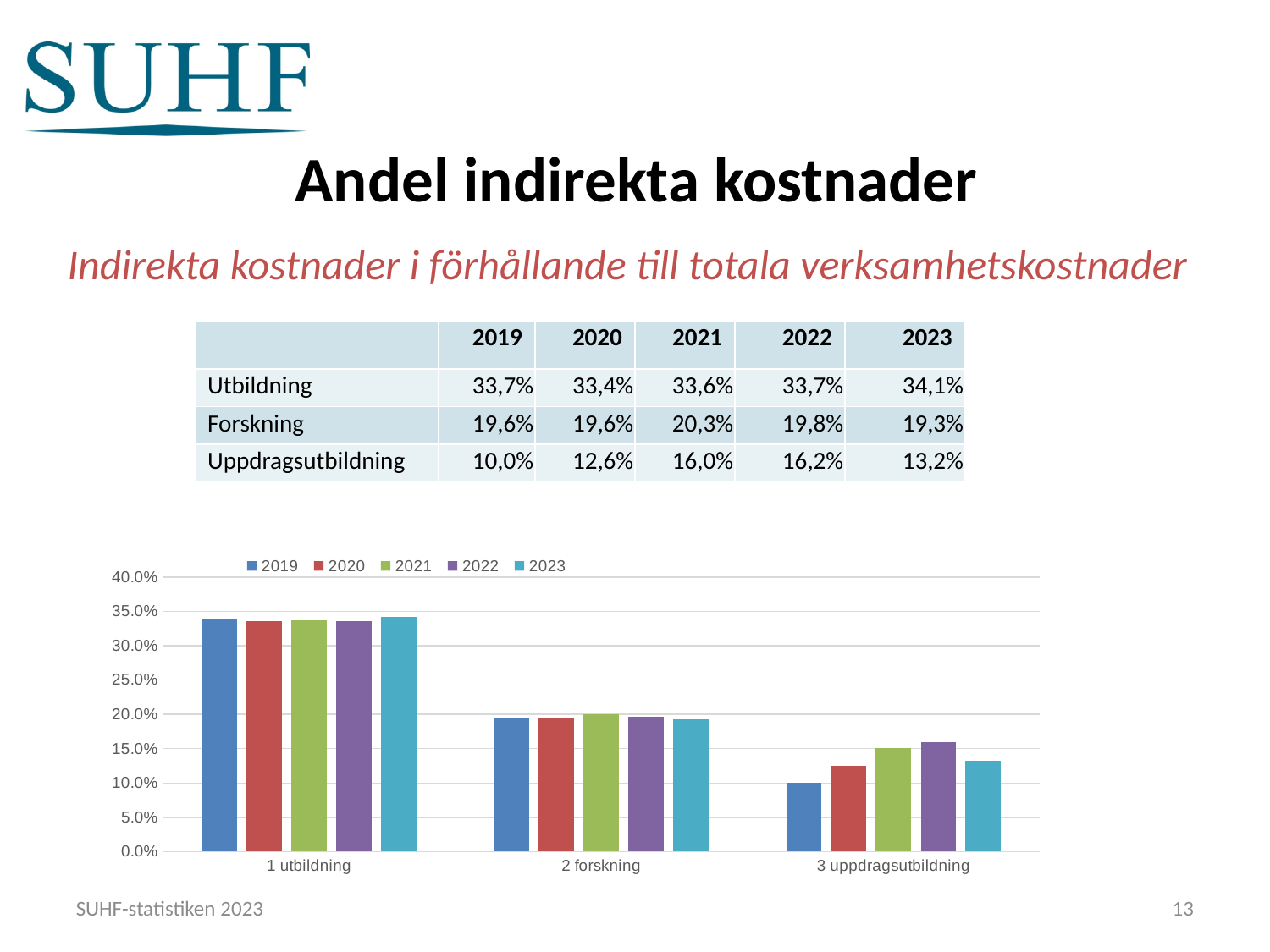
Using the table values, what is the difference between Uppdragsutbildning in 2022 and in 2019? 6,2% Which category has the lowest values in the chart? 3 uppdragsutbildning Which is larger for 3 uppdragsutbildning: the 2022 bar or the 2023 bar? 2022 According to the table, what is the value for Forskning in 2021? 20,3% Is the 2023 value for 1 utbildning greater or less than 30.0%? greater Is the 2019 value for 3 uppdragsutbildning greater or less than 15.0%? less According to the table, what is the value for Uppdragsutbildning in 2019? 10,0% According to the table, what is the value for Utbildning in 2023? 34,1% What kind of chart is shown on the slide? bar chart Which category has the highest values in the chart? 1 utbildning How many categories are shown on the x axis of the chart? 3 How many series does the chart legend list? 5